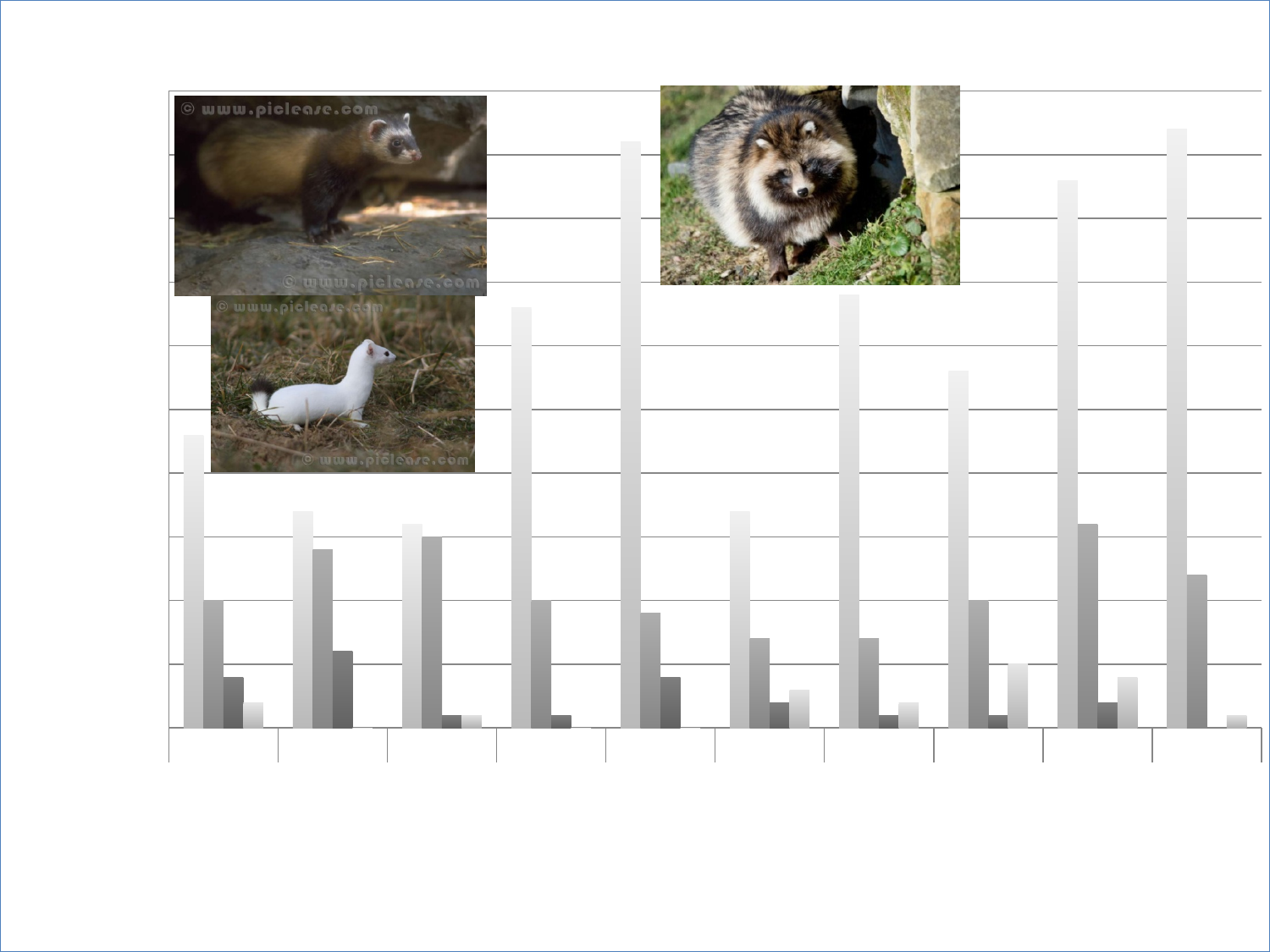
Counting from the left, which category group contains the tallest bar in the chart? the 10th group How many category groups are plotted along the x axis of the bar chart? 10 Does the chart display any axis labels or data labels? No What kind of chart is shown on the slide? bar chart How many bars are shown in each category group of the bar chart? 4 Within each group, is the lightest-coloured bar generally the tallest or the shortest? the tallest